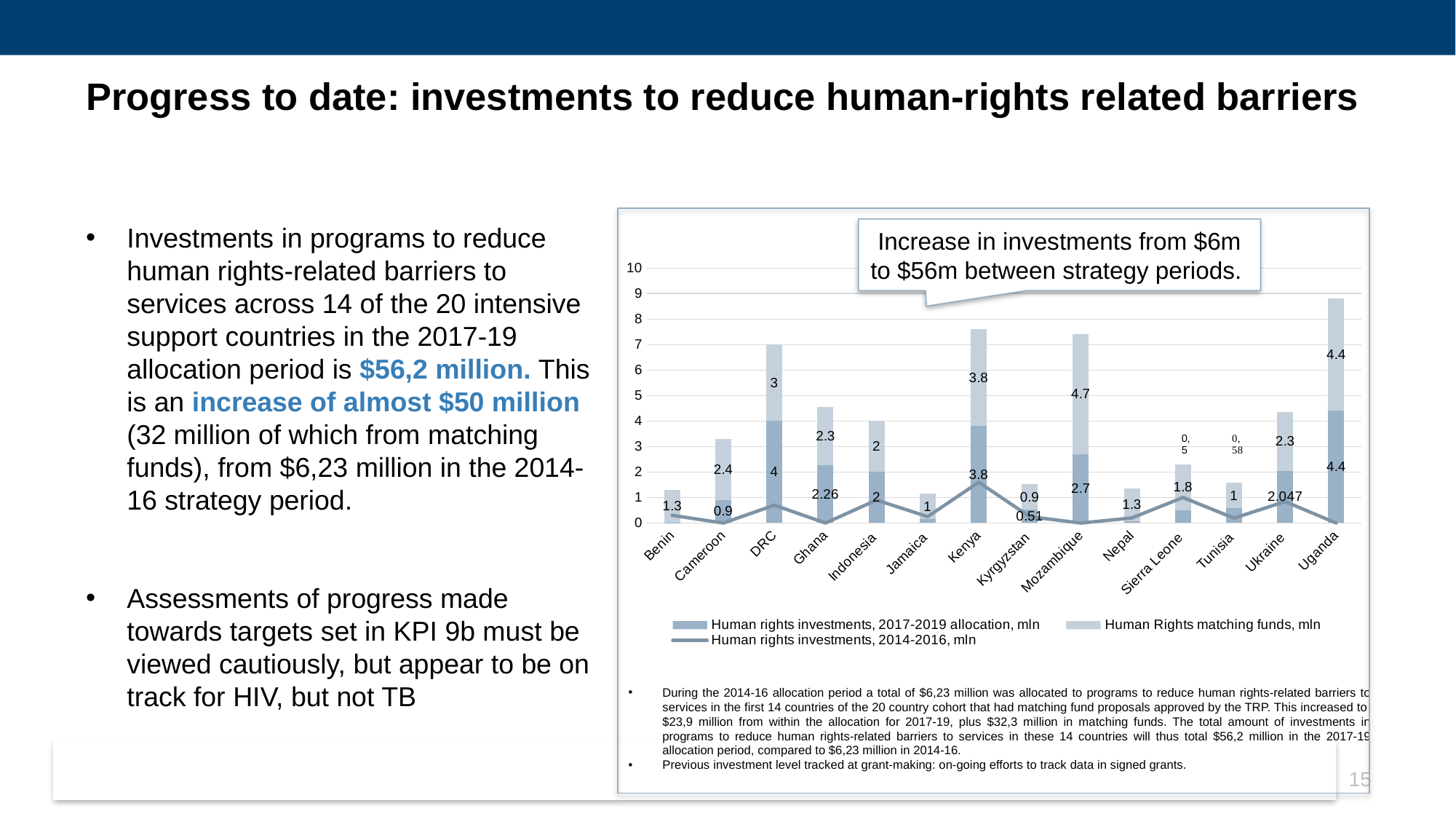
Which country has the tallest stacked bar in the chart? Uganda What is the value of Human rights investments, 2017-2019 allocation for Ukraine? 2.047 What is the value of Human rights investments, 2017-2019 allocation for DRC? 4 What is the value of Human Rights matching funds for Mozambique? 4.7 What is the total of the stacked bar for Uganda? 8.8 Which is larger: the 2017-2019 allocation for DRC or for Mozambique? DRC How many series does the chart legend list? 3 What kind of chart is shown on the slide? Stacked bar chart with a line How many countries are shown on the x axis of the chart? 14 What is the value of Human Rights matching funds for Cameroon? 2.4 What is the difference between the matching funds and the 2017-2019 allocation for Mozambique? 2 What does the callout box on the chart say? Increase in investments from $6m to $56m between strategy periods.